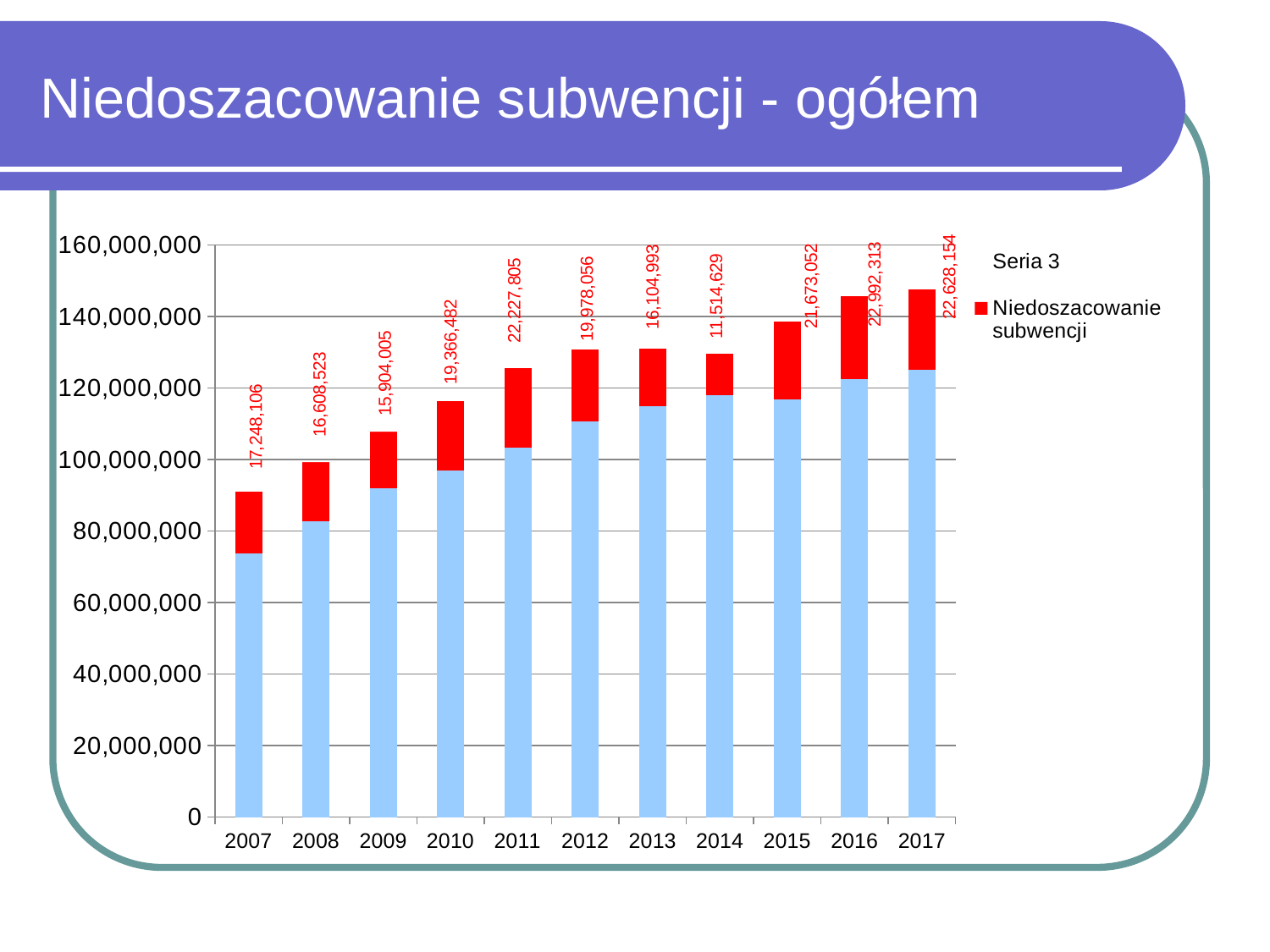
What is the difference between the Niedoszacowanie subwencji values for 2011 and 2010? 2,861,323 What is the value of Niedoszacowanie subwencji for 2011? 22,227,805 Is the total height of the 2017 bar greater or less than 140,000,000? greater In which year is the Niedoszacowanie subwencji value the highest? 2016 What type of chart is shown on the slide? Stacked bar chart What is the value of Niedoszacowanie subwencji for 2014? 11,514,629 In which year is the Niedoszacowanie subwencji value the lowest? 2014 How many years are shown on the x axis? 11 What is the value of Niedoszacowanie subwencji for 2017? 22,628,154 Which year has a larger Niedoszacowanie subwencji value, 2009 or 2015? 2015 Do the total bar heights generally rise or fall from 2007 to 2017? Rise Is the total height of the 2007 bar greater or less than 100,000,000? less